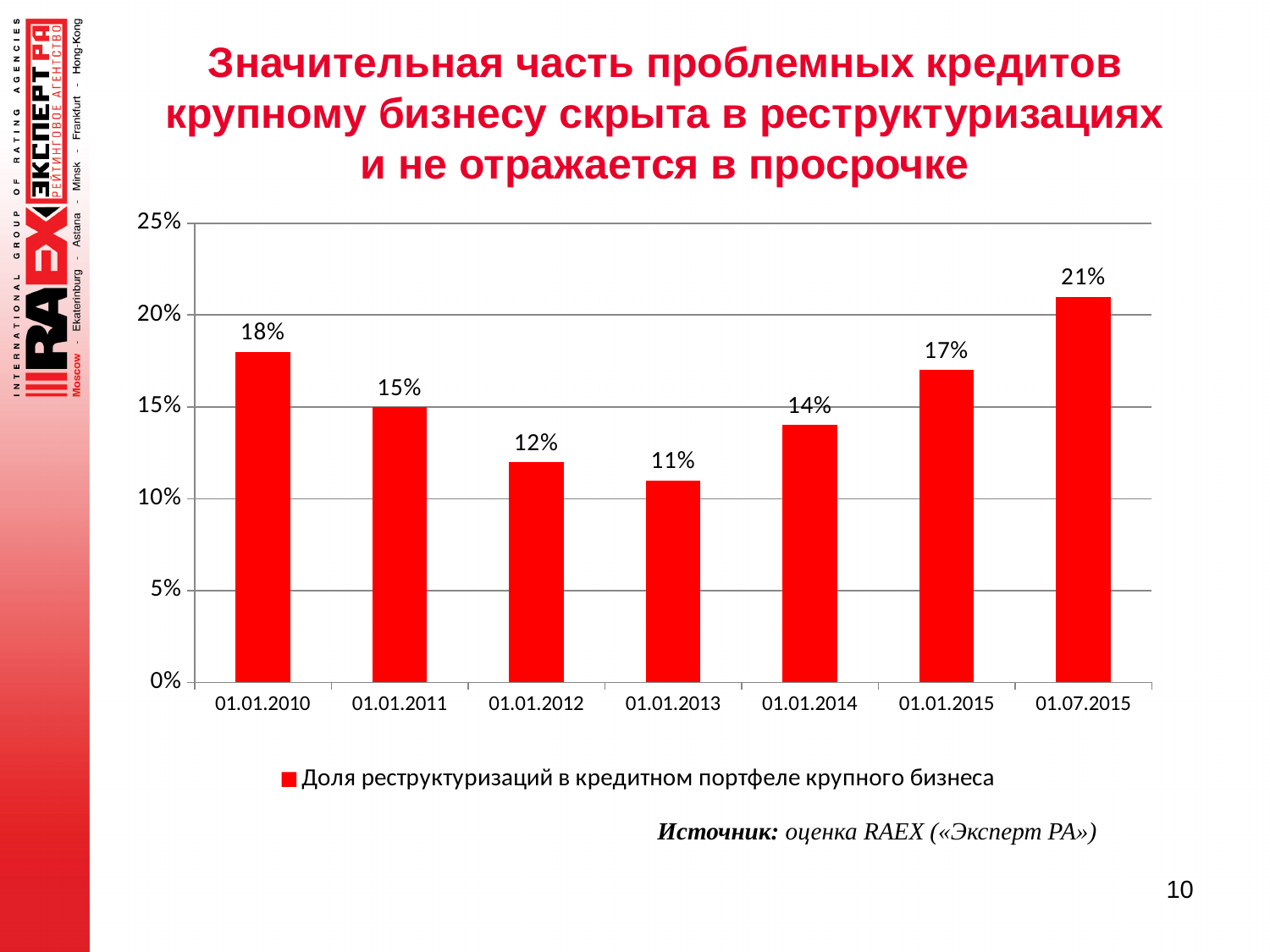
What is the value for 01.01.2010? 18% What is the legend entry for the series shown? Доля реструктуризаций в кредитном портфеле крупного бизнеса How many dates are shown on the x axis? 7 What is the value for 01.01.2013? 11% Do the values rise or fall from 01.01.2013 to 01.07.2015? rise How many series does the legend list? 1 Which date has the lowest value? 01.01.2013 What kind of chart is shown on the slide? bar chart Which date has the highest value? 01.07.2015 What is the value for 01.07.2015? 21% Which is larger, the value for 01.01.2011 or the value for 01.01.2014? 01.01.2011 What is the difference between the values for 01.07.2015 and 01.01.2013? 10%